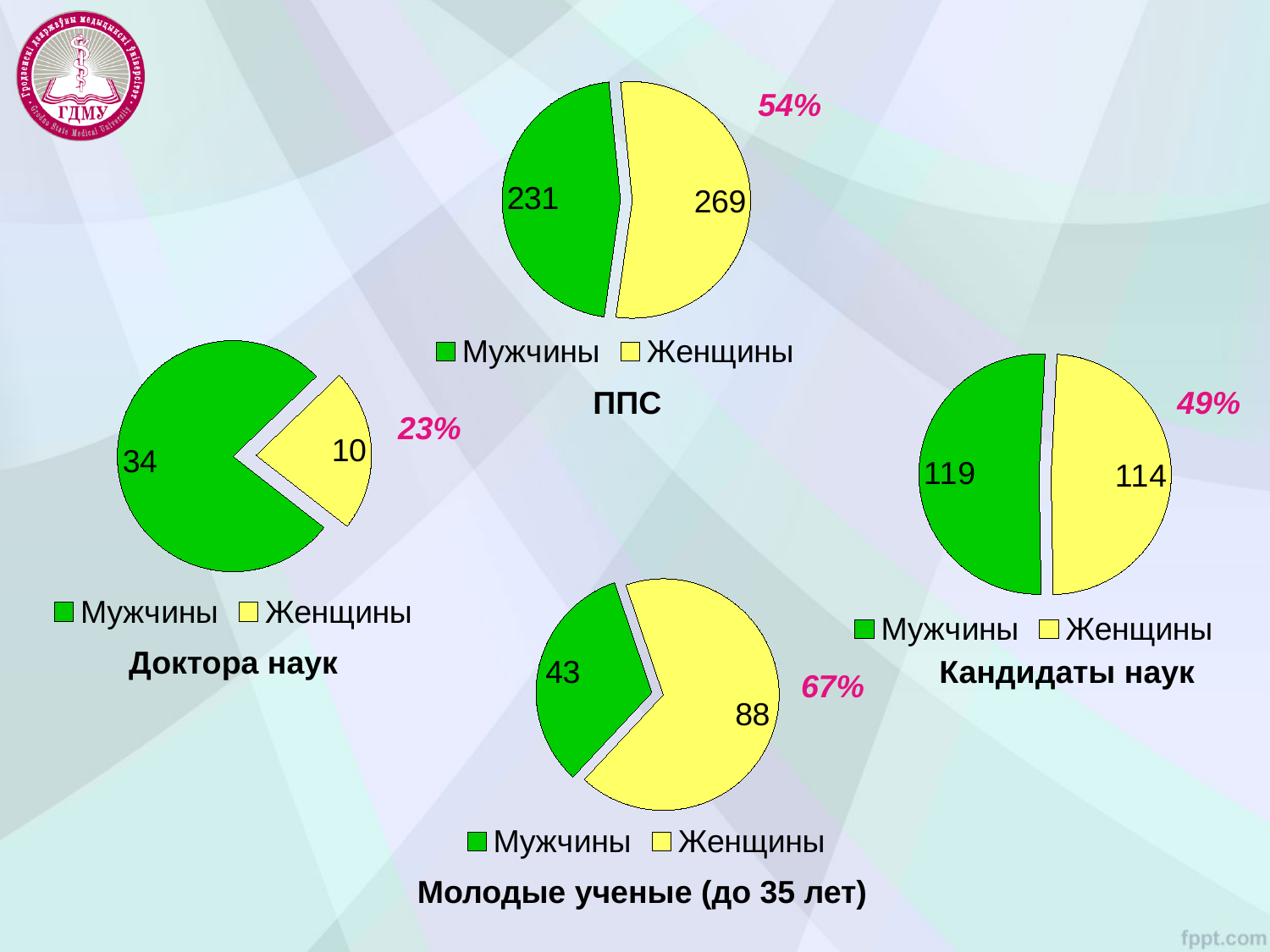
In the Доктора наук chart, which category is the largest? Мужчины How many series does the legend of the ППС chart list? 2 In the Молодые ученые (до 35 лет) chart, what is the value for Женщины? 88 What kind of chart is the Доктора наук chart? Pie chart In the Молодые ученые (до 35 лет) chart, what share of the pie is Женщины? 67% In the Молодые ученые (до 35 лет) chart, which category is the smallest? Мужчины In the ППС chart, what is the difference between Женщины and Мужчины? 38 In the ППС chart, what is the value for Мужчины? 231 In the ППС chart, what is the value for Женщины? 269 In the Кандидаты наук chart, what is the total of Мужчины and Женщины? 233 In the Доктора наук chart, what is the value for Женщины? 10 In the Кандидаты наук chart, what is the value for Мужчины? 119